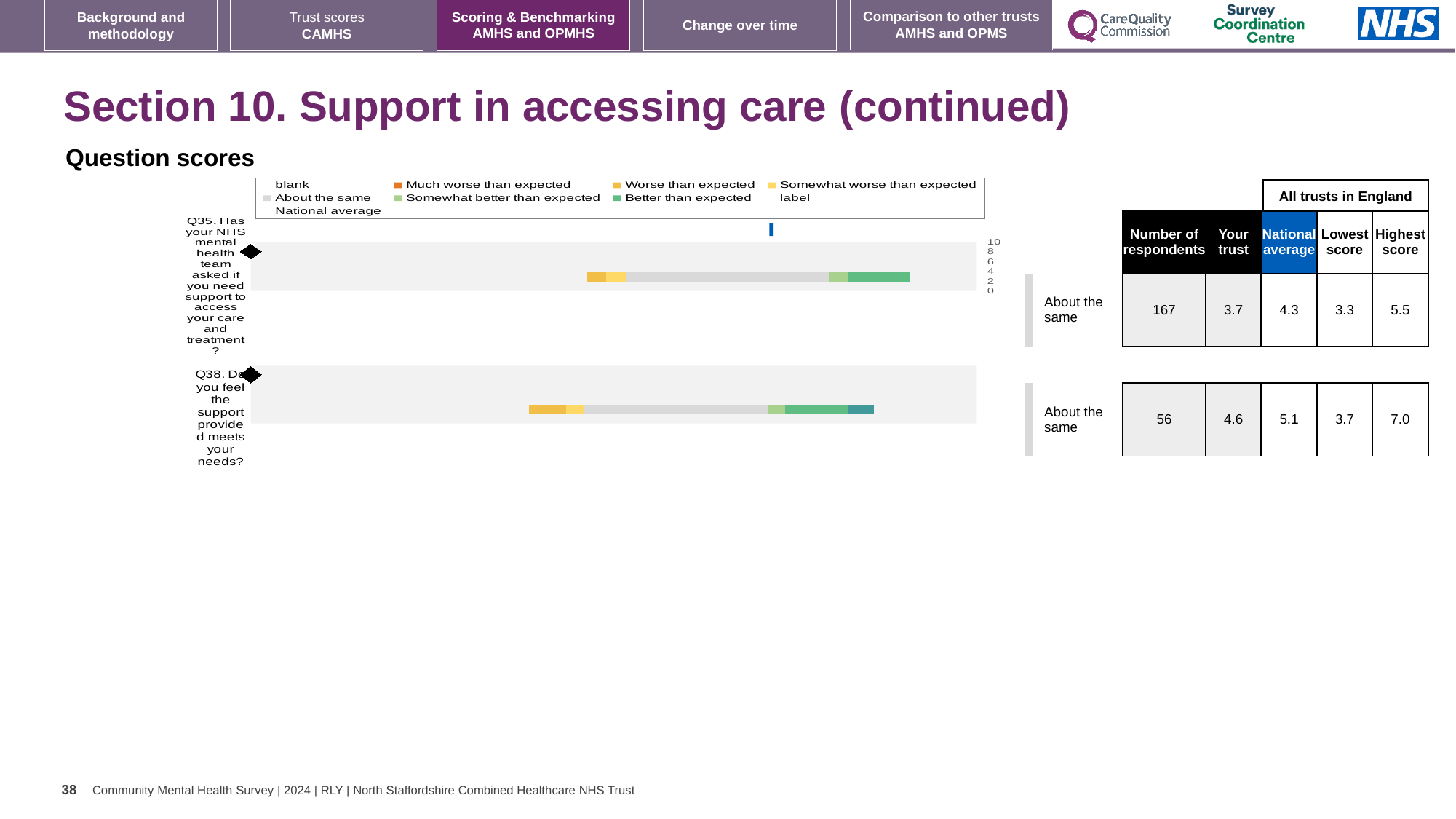
For Q35, which is larger: the "Your trust" score or the national average? National average How many entries does the legend of the Question scores chart list? 9 What is the national average score for Q35? 4.3 What kind of chart is shown under "Question scores"? bar chart How many questions (categories) are plotted in the Question scores chart? 2 In the Question scores chart legend, which entry is shown in light grey? About the same In the Question scores chart legend, which entry is shown in orange? Much worse than expected What is the highest score across all trusts in England for Q38? 7.0 What is the "Your trust" score for Q38 (Do you feel the support provided meets your needs?)? 4.6 Which question has the higher number of respondents, Q35 or Q38? Q35 What is the difference between the national average and the "Your trust" score for Q35? 0.6 What is the number of respondents for Q35 in the Question scores table? 167